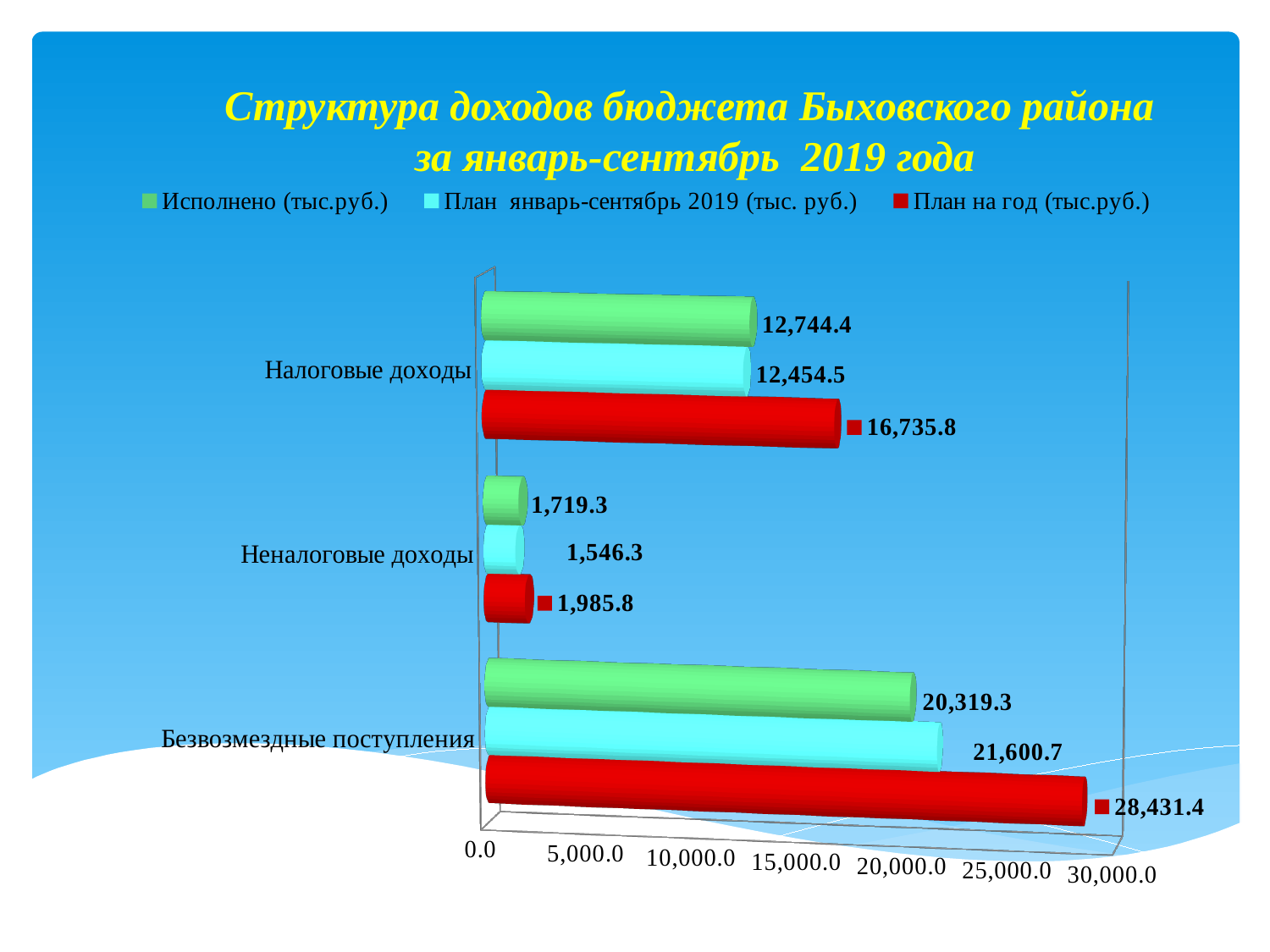
What is the value of "Исполнено (тыс.руб.)" for "Налоговые доходы"? 12,744.4 What is the value of "План январь-сентябрь 2019 (тыс. руб.)" for "Неналоговые доходы"? 1,546.3 What is the difference between "План на год (тыс.руб.)" and "План январь-сентябрь 2019 (тыс. руб.)" for "Безвозмездные поступления"? 6,830.7 What is the value of "План на год (тыс.руб.)" for "Безвозмездные поступления"? 28,431.4 How many series does the legend list? 3 What is the difference between "План на год (тыс.руб.)" and "Исполнено (тыс.руб.)" for "Налоговые доходы"? 3,991.4 Which category has the lowest value for "Исполнено (тыс.руб.)"? Неналоговые доходы How many categories are shown on the chart? 3 Is the value of "План на год (тыс.руб.)" for "Налоговые доходы" greater or less than 15,000.0? greater What kind of chart is shown on the slide? Bar chart For "Налоговые доходы", which is larger: "Исполнено (тыс.руб.)" or "План январь-сентябрь 2019 (тыс. руб.)"? Исполнено (тыс.руб.) Which category has the highest value for "План на год (тыс.руб.)"? Безвозмездные поступления